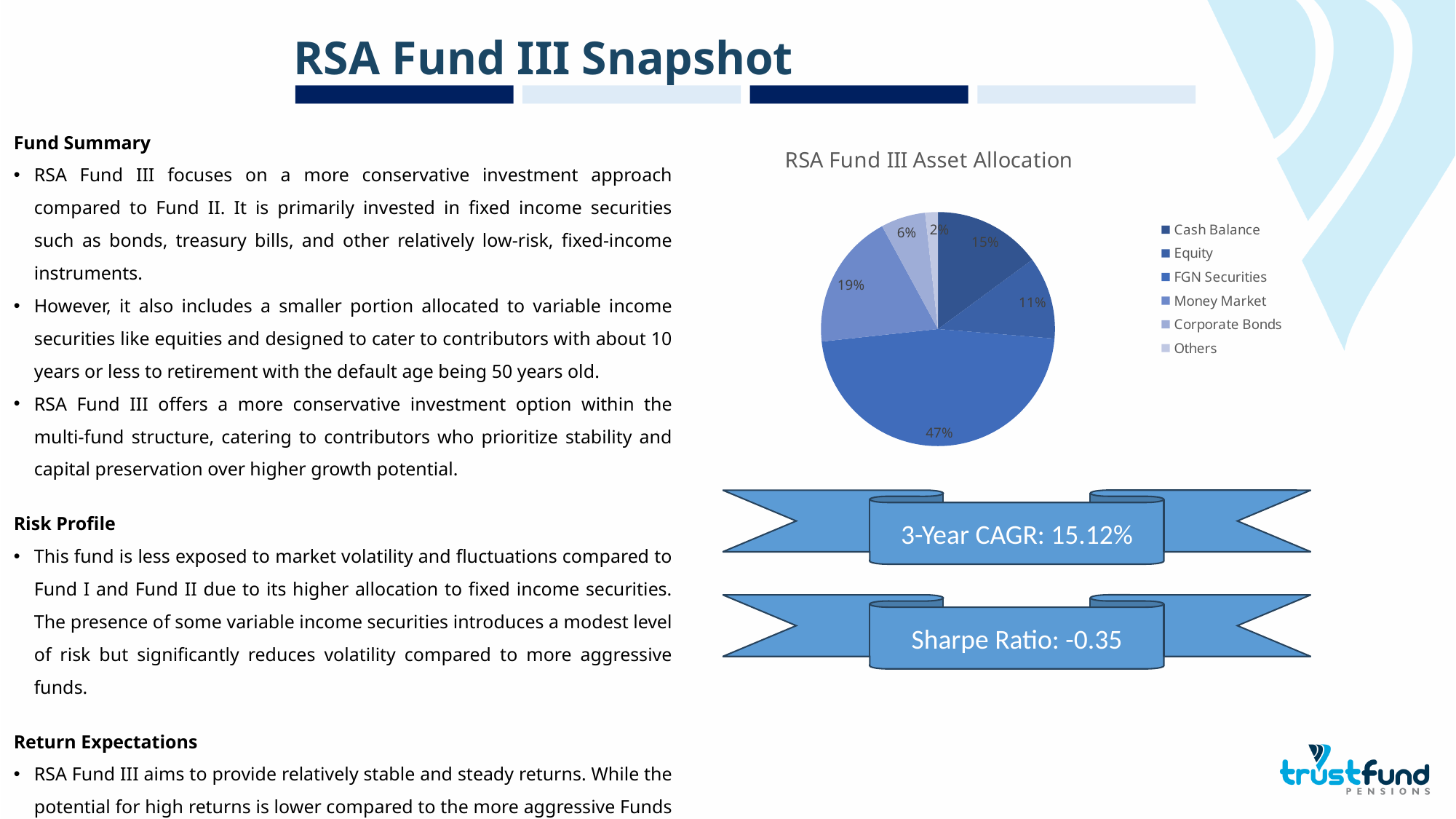
What share of the pie is Money Market? 19% What is the difference in percentage points between the FGN Securities slice and the Money Market slice? 28 Which category has the smallest slice of the pie? Others What share of the pie is Equity? 11% What type of chart is shown on the slide? Pie chart What share of the pie is Cash Balance? 15% Which category has the largest slice of the pie? FGN Securities How many categories does the legend of the pie chart list? 6 Which slice is larger, Cash Balance or Equity? Cash Balance What is the title of the chart? RSA Fund III Asset Allocation